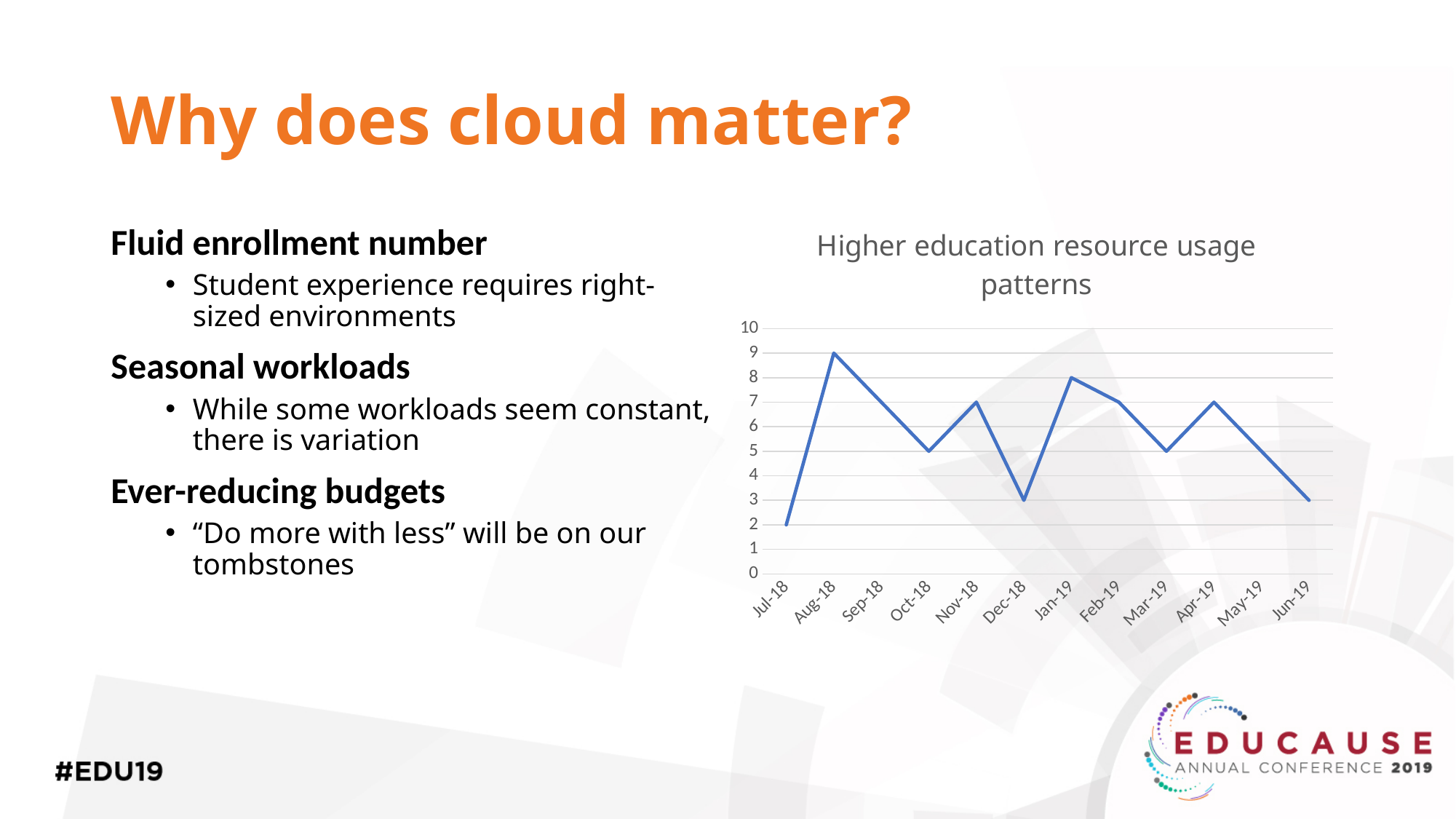
What is the title of the chart? Higher education resource usage patterns What type of chart is shown on the slide? line chart What is the value for Aug-18? 9 Which month has the highest value in the chart? Aug-18 Does the value rise or fall from Apr-19 to Jun-19? fall What is the value for Jan-19? 8 Is the value for Jun-19 greater or less than 5? less What is the value for Dec-18? 3 How many months are plotted on the x axis of the chart? 12 Which month has the lowest value in the chart? Jul-18 Which is larger, the value for Jan-19 or the value for Mar-19? Jan-19 What is the difference between the values for Aug-18 and Jul-18? 7